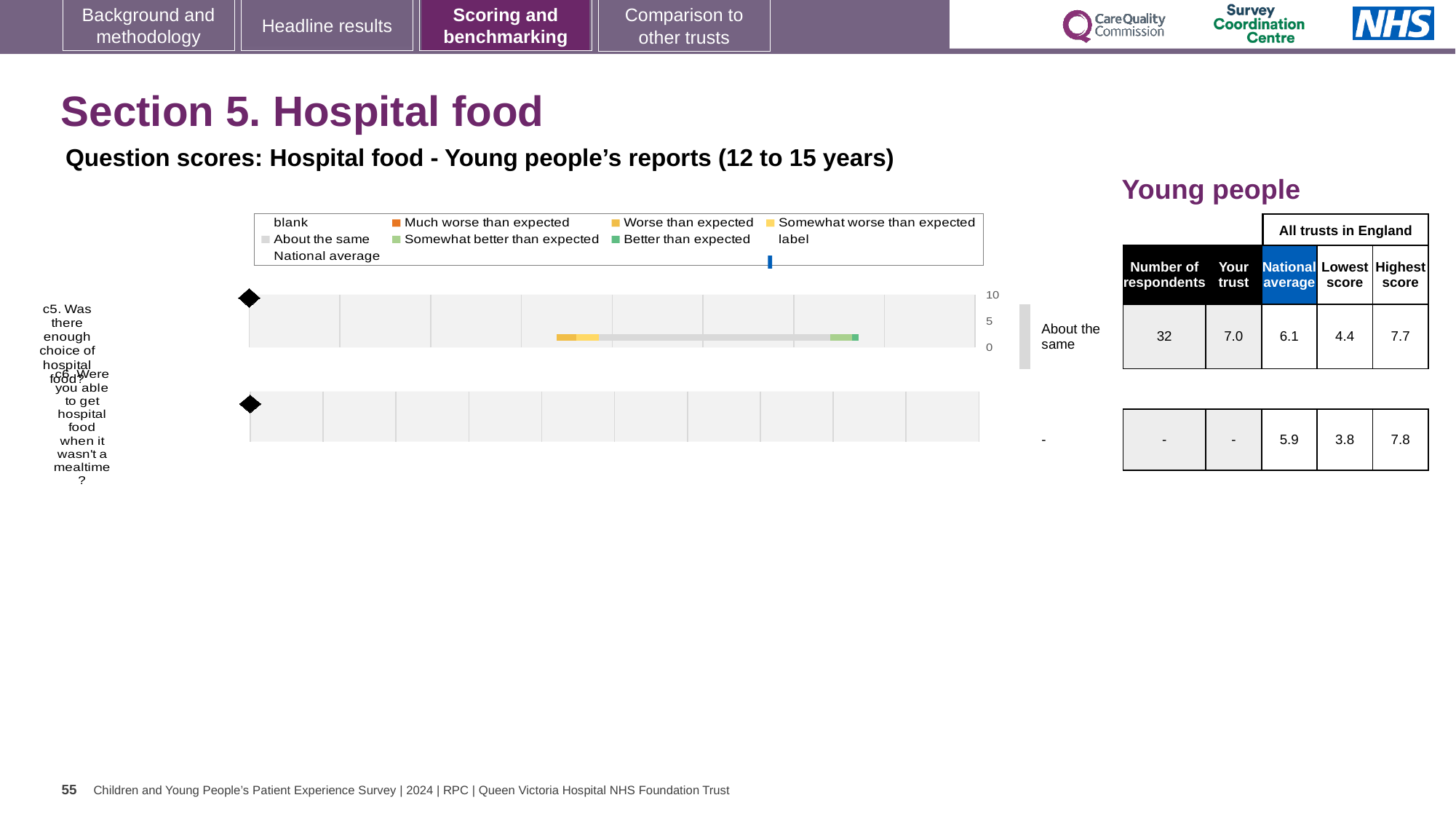
How many questions are plotted in the hospital food chart? 2 How many respondents answered question c5 (Was there enough choice of hospital food?)? 32 For question c5, what is the difference between the 'Your trust' score and the national average? 0.9 What is the highest score among all trusts in England for question c5? 7.7 What is the 'Your trust' score for question c5 (Was there enough choice of hospital food?)? 7.0 What kind of chart is used to show the question scores for hospital food? bar chart For question c5, which is larger: the 'Your trust' score or the national average? Your trust What is the lowest score among all trusts in England for question c5? 4.4 What is the national average score for question c6 (Were you able to get hospital food when it wasn't a mealtime?)? 5.9 What benchmark category is shown for the trust's score on question c5? About the same For question c5, what is the difference between the highest and lowest scores among all trusts in England? 3.3 What is the national average score for question c5 (Was there enough choice of hospital food?)? 6.1